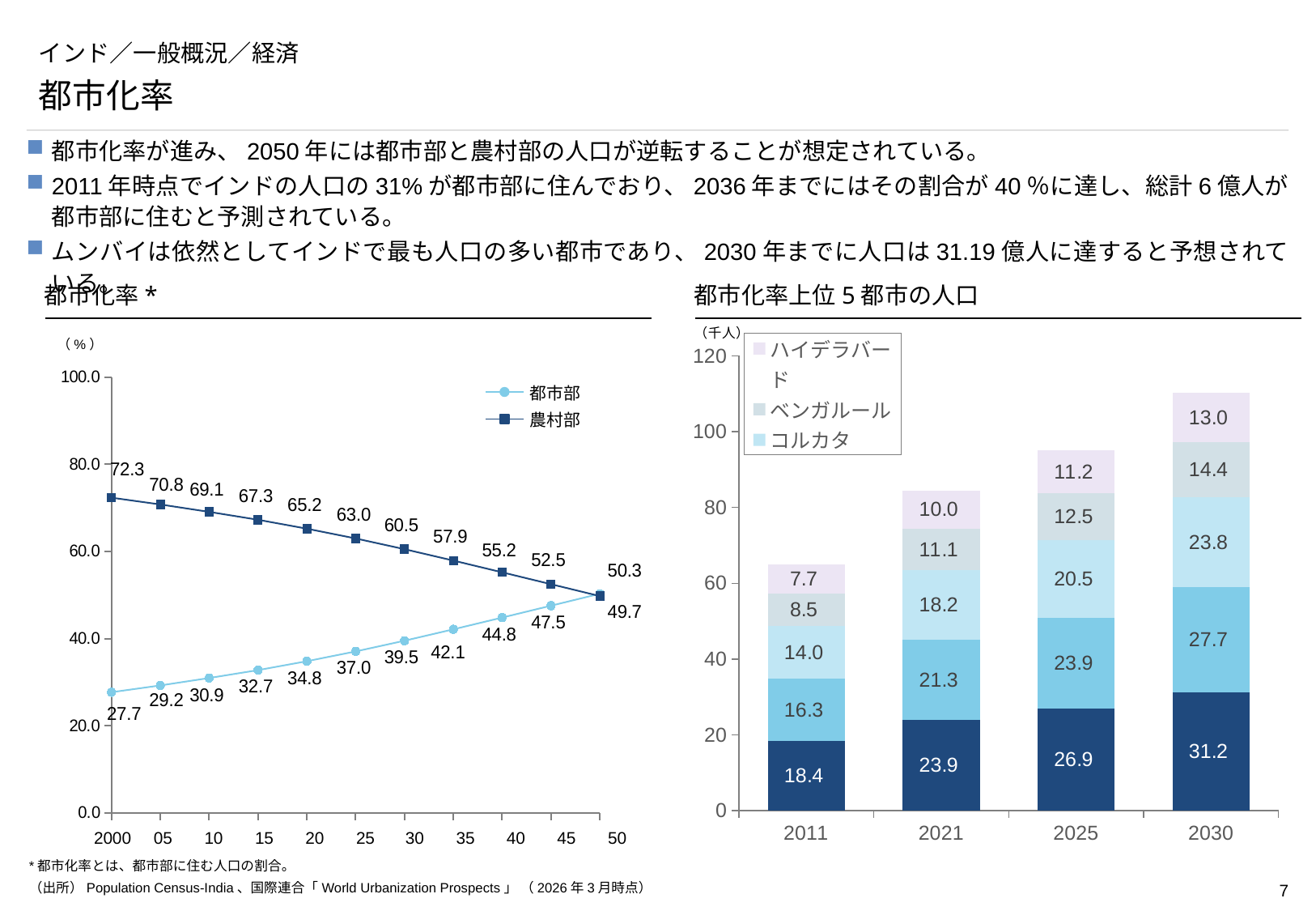
In the 都市化率* chart, how many series does the legend list? 2 In the 都市化率上位5都市の人口 chart, what is the total of the stacked bar for 2011? 64.9 In the 都市化率上位5都市の人口 chart, which is larger in 2025: ベンガルール or ハイデラバード? ベンガルール In the 都市化率上位5都市の人口 chart, what is the value for コルカタ in 2021? 18.2 In the 都市化率上位5都市の人口 chart, how many years are shown on the x axis? 4 In the 都市化率* chart, what is the difference between 農村部 and 都市部 in 2000? 44.6 In the 都市化率* chart, what is the value for 都市部 in 2000? 27.7 What kind of chart is the 都市化率* chart? line chart What kind of chart is the 都市化率上位5都市の人口 chart? stacked bar chart In the 都市化率* chart, what is the value for 農村部 in 2050? 49.7 In the 都市化率上位5都市の人口 chart, what is the value for ハイデラバード in 2030? 13.0 In the 都市化率* chart, does the 都市部 series rise or fall from 2000 to 2050? rise